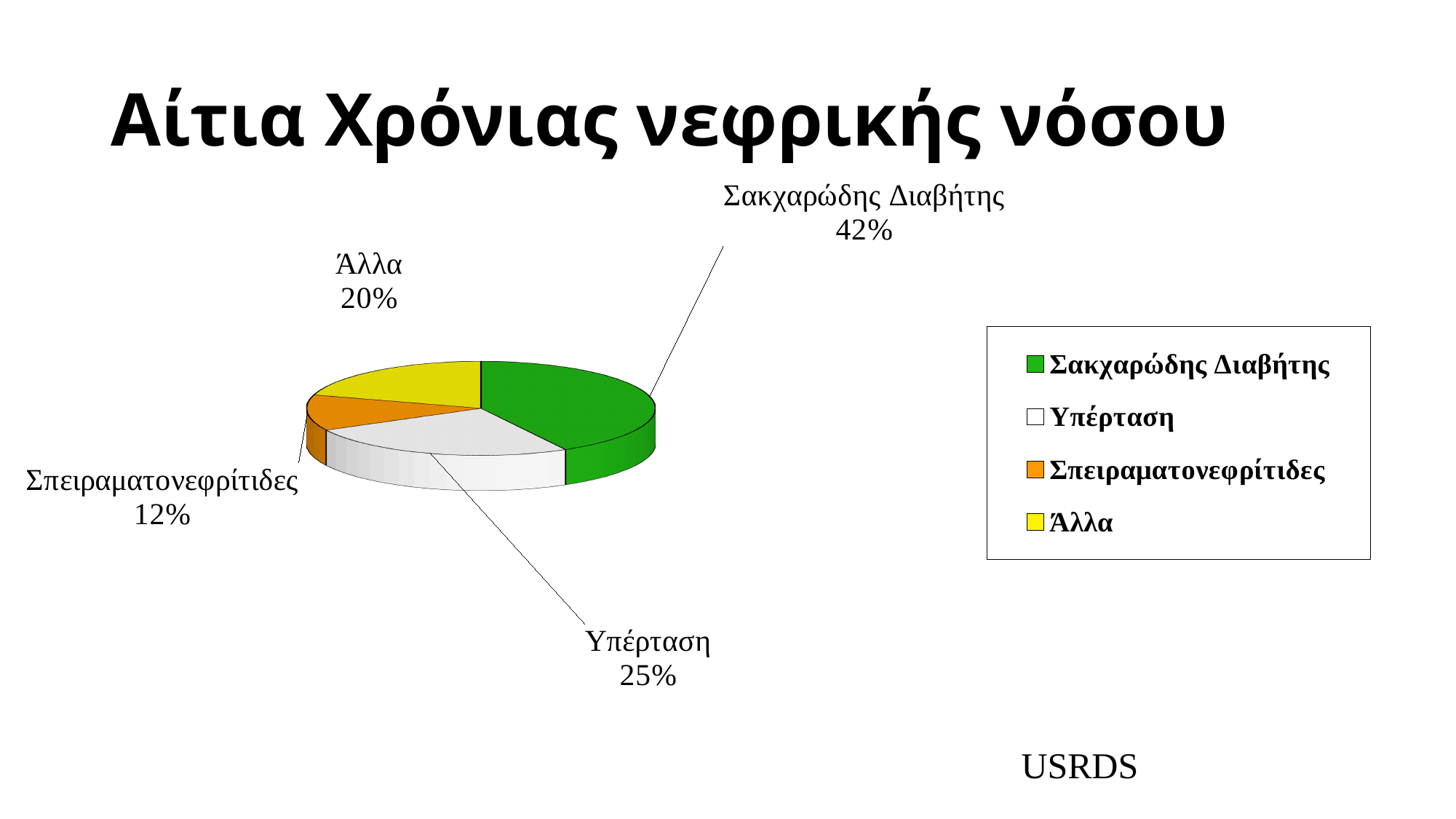
What percentage of the pie is Άλλα? 20% What percentage of the pie is Σπειραματονεφρίτιδες? 12% What is the title of the slide? Αίτια Χρόνιας νεφρικής νόσου What colour is the Υπέρταση slice in the legend? White How many slices does the pie chart have? 4 What kind of chart is shown on the slide? Pie chart What is the difference in percentage points between Σακχαρώδης Διαβήτης and Υπέρταση? 17 Which category has the largest share of the pie? Σακχαρώδης Διαβήτης Which is larger, the share for Άλλα or the share for Σπειραματονεφρίτιδες? Άλλα What percentage of the pie is Υπέρταση? 25% What percentage of the pie is Σακχαρώδης Διαβήτης? 42% Which category has the smallest share of the pie? Σπειραματονεφρίτιδες